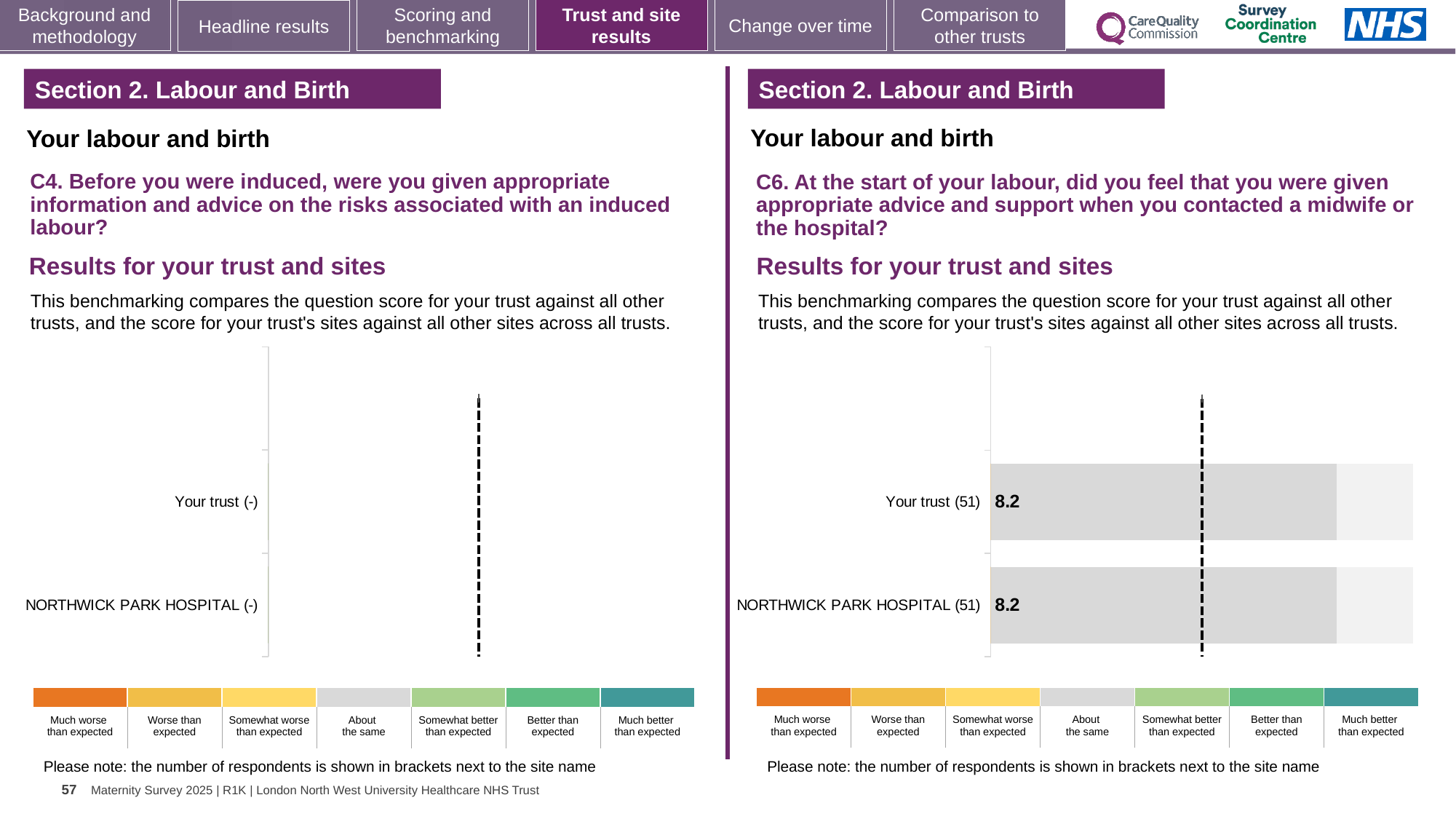
On the right-hand chart (C6), how many respondents are shown in brackets next to Your trust? 51 How many bands does the colour key below the right-hand chart (C6) contain? 7 How many categories are plotted on the right-hand chart (C6)? 2 On the right-hand chart (C6), are the scores for Your trust and NORTHWICK PARK HOSPITAL equal? Yes On the right-hand chart (C6), what is the score for NORTHWICK PARK HOSPITAL? 8.2 On the right-hand chart (C6), what is the difference between the score for Your trust and the score for NORTHWICK PARK HOSPITAL? 0 How many categories are listed on the left-hand chart (C4)? 2 What kind of chart is the right-hand chart (C6)? Bar chart On the right-hand chart (C6), what is the score for Your trust? 8.2